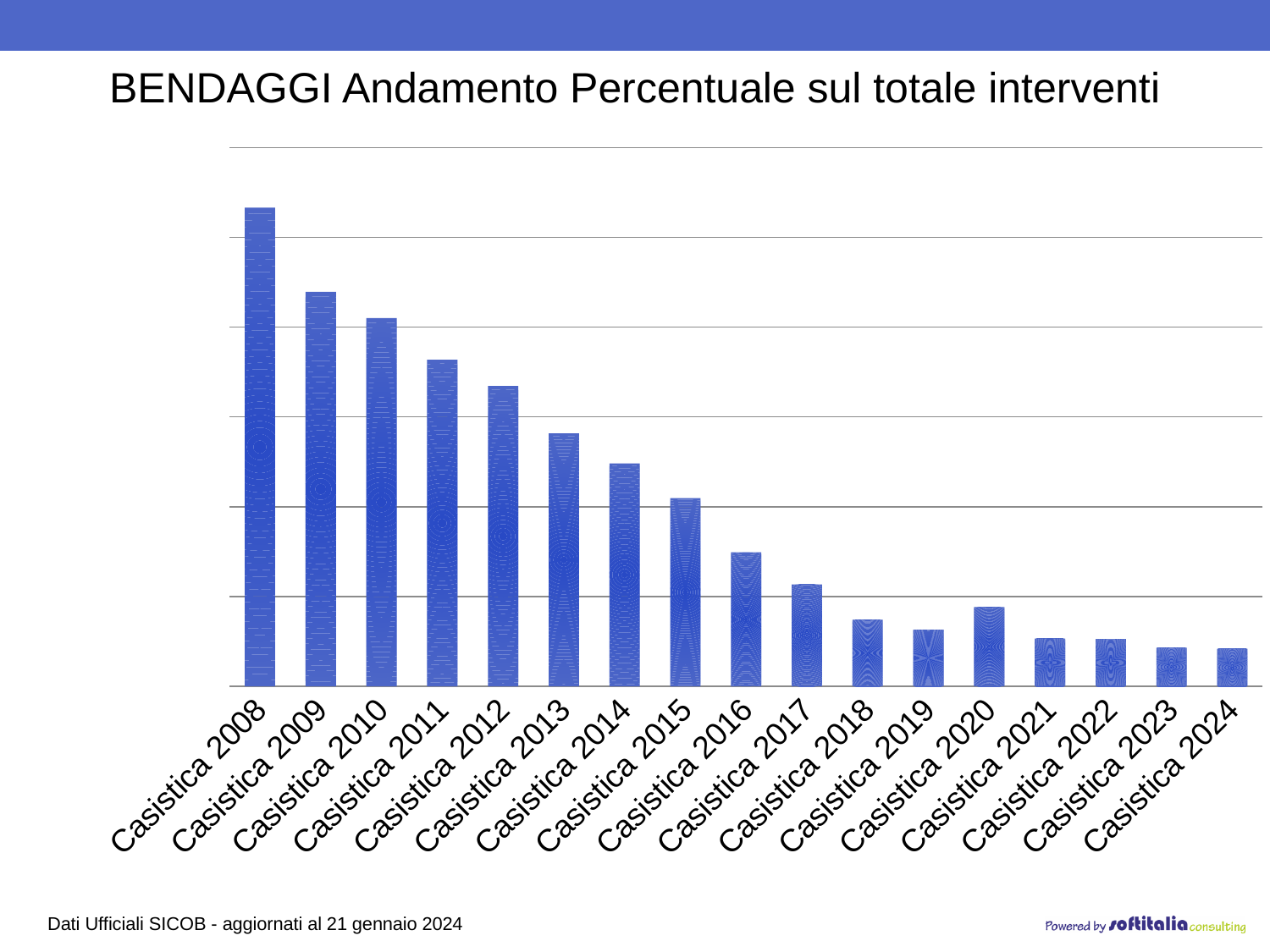
Which is larger, the value for Casistica 2019 or Casistica 2020? Casistica 2020 What is the title of the chart? BENDAGGI Andamento Percentuale sul totale interventi What is the first category on the x axis? Casistica 2008 How many categories (bars) are plotted in the chart? 17 Which category has the highest bar? Casistica 2008 What kind of chart is shown on the slide? bar chart Which is larger, the value for Casistica 2015 or Casistica 2016? Casistica 2015 Which is larger, the value for Casistica 2012 or Casistica 2014? Casistica 2012 Do the values generally rise or fall from Casistica 2008 to Casistica 2024? fall